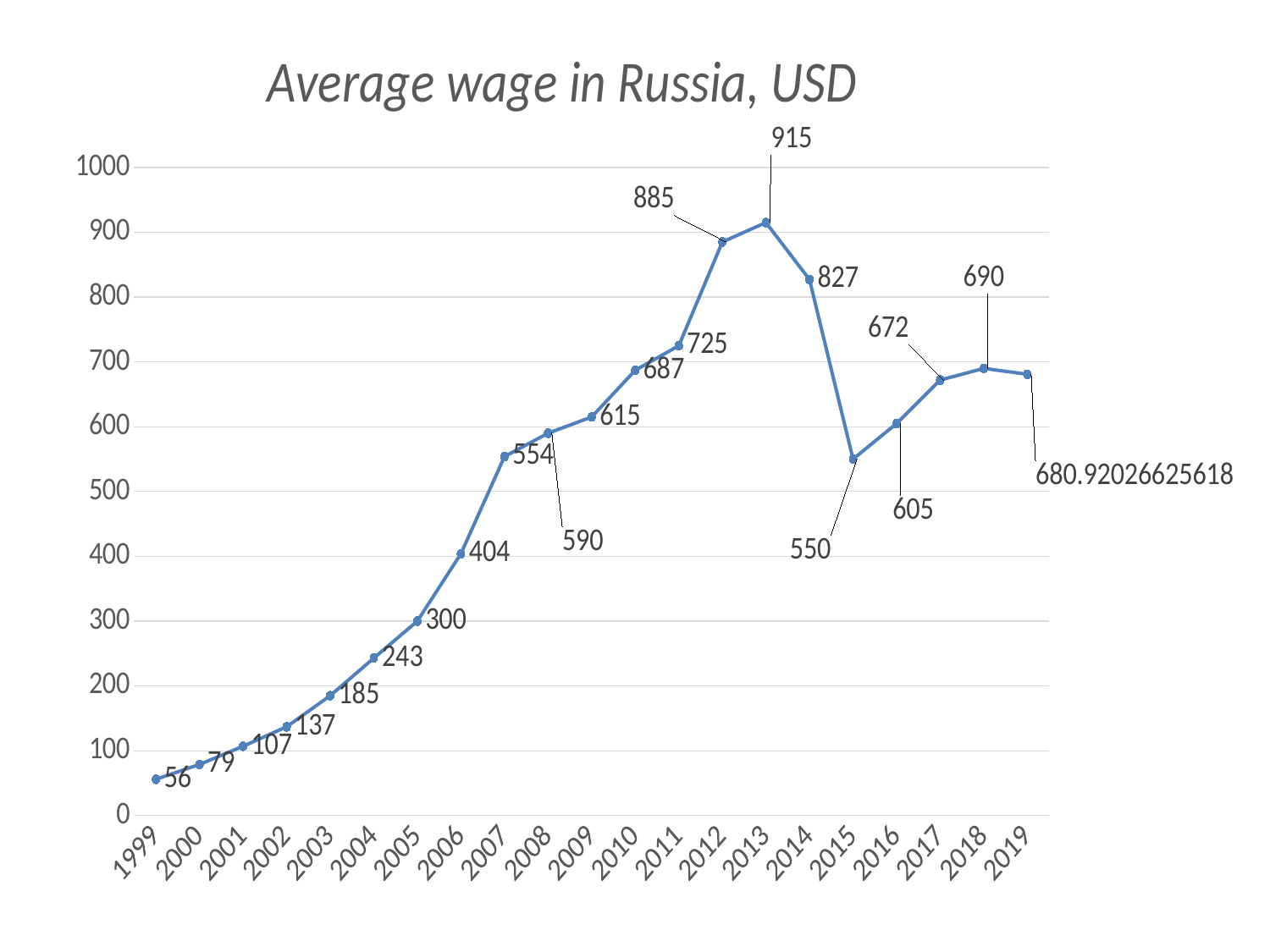
What kind of chart is shown on the slide? Line chart What is the average wage in Russia for 2013? 915 By how much did the average wage fall from 2014 to 2015? 277 Which year has the highest average wage? 2013 What is the difference between the values for 2013 and 2012? 30 How many years are plotted on the chart? 21 What is the average wage in Russia for 2015? 550 What value is shown for 2006? 404 Does the average wage rise or fall from 1999 to 2007? Rise Which year has the lowest average wage? 1999 Is the value for 2008 greater or less than 500? greater Which year has the larger value, 2011 or 2017? 2011